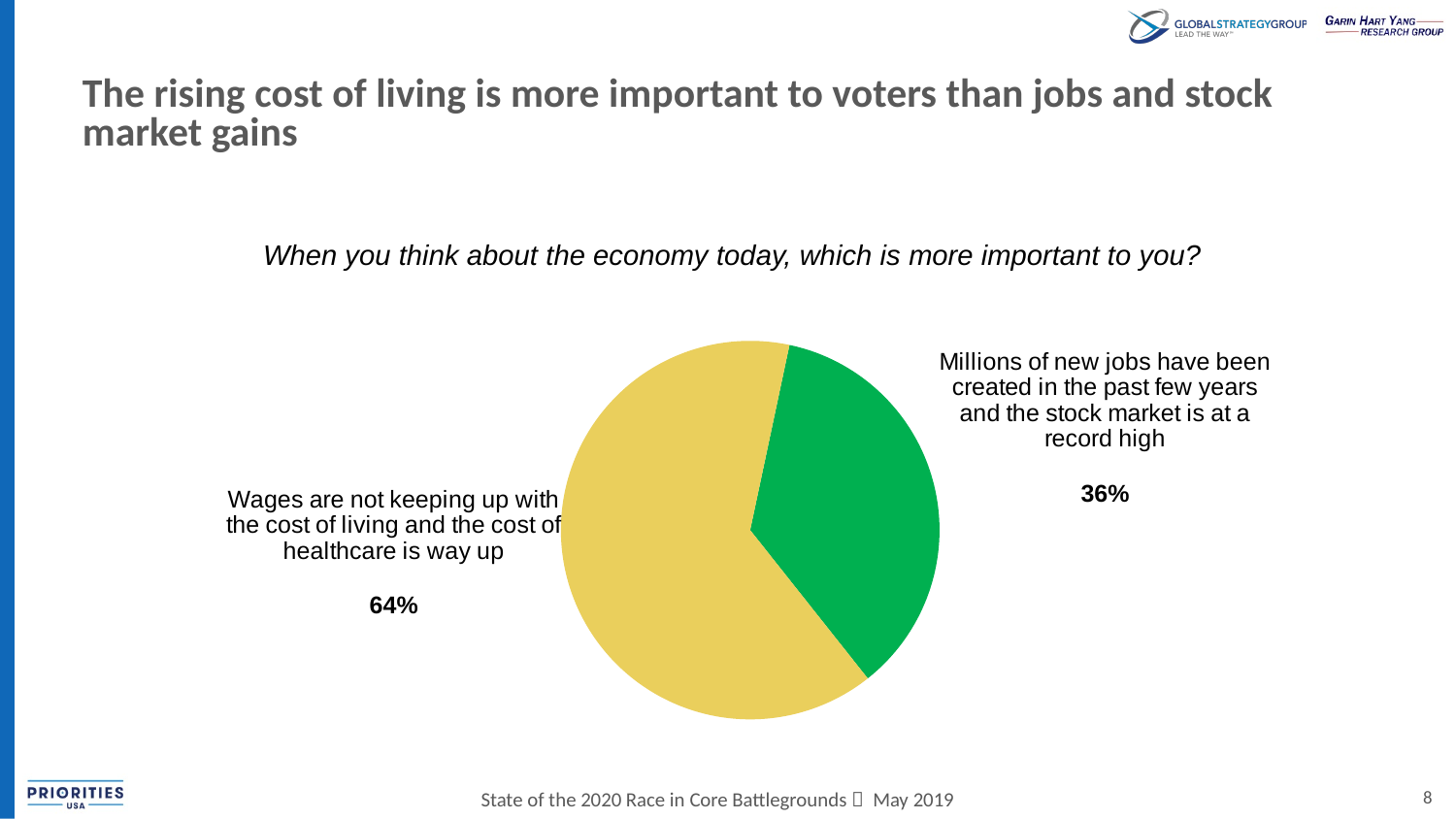
What kind of chart is shown on the slide? Pie chart How many slices does the pie chart have? 2 What is the difference in percentage points between the wages/cost of living response and the new jobs/stock market response? 28 Which response has the smaller share of the pie? Millions of new jobs have been created in the past few years and the stock market is at a record high What percentage of voters chose "Wages are not keeping up with the cost of living and the cost of healthcare is way up"? 64% What survey question is the pie chart based on? When you think about the economy today, which is more important to you? What colour is the slice for "Wages are not keeping up with the cost of living and the cost of healthcare is way up"? Yellow Which response has the larger share of the pie? Wages are not keeping up with the cost of living and the cost of healthcare is way up Is the share for the wages/cost of living response larger or smaller than the share for the new jobs/stock market response? Larger What share of the pie does the green slice represent? 36% What percentage of voters chose "Millions of new jobs have been created in the past few years and the stock market is at a record high"? 36%